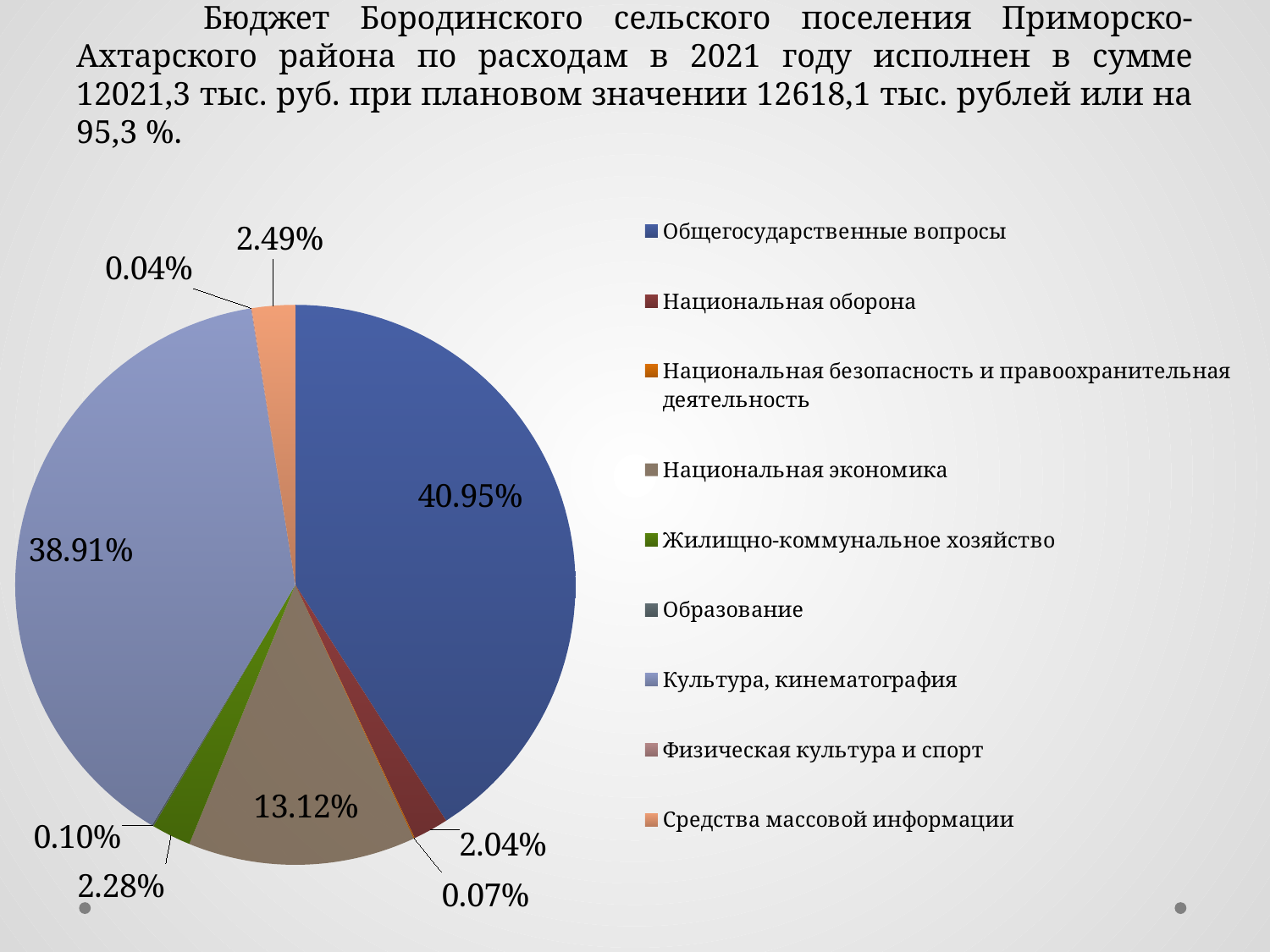
How many categories does the legend of the pie chart list? 9 What share of the pie does "Жилищно-коммунальное хозяйство" have? 2.28% What kind of chart is shown on the slide? pie chart What share of the pie does "Средства массовой информации" have? 2.49% What share of the pie does "Национальная оборона" have? 2.04% What share of the pie does "Общегосударственные вопросы" have? 40.95% Which category has the largest slice of the pie? Общегосударственные вопросы Which category has the smallest slice of the pie? Физическая культура и спорт What share of the pie does "Национальная экономика" have? 13.12% What is the difference in percentage points between "Общегосударственные вопросы" and "Культура, кинематография"? 2.04 Which is larger: the slice for "Национальная экономика" or the slice for "Средства массовой информации"? Национальная экономика What share of the pie does "Культура, кинематография" have? 38.91%